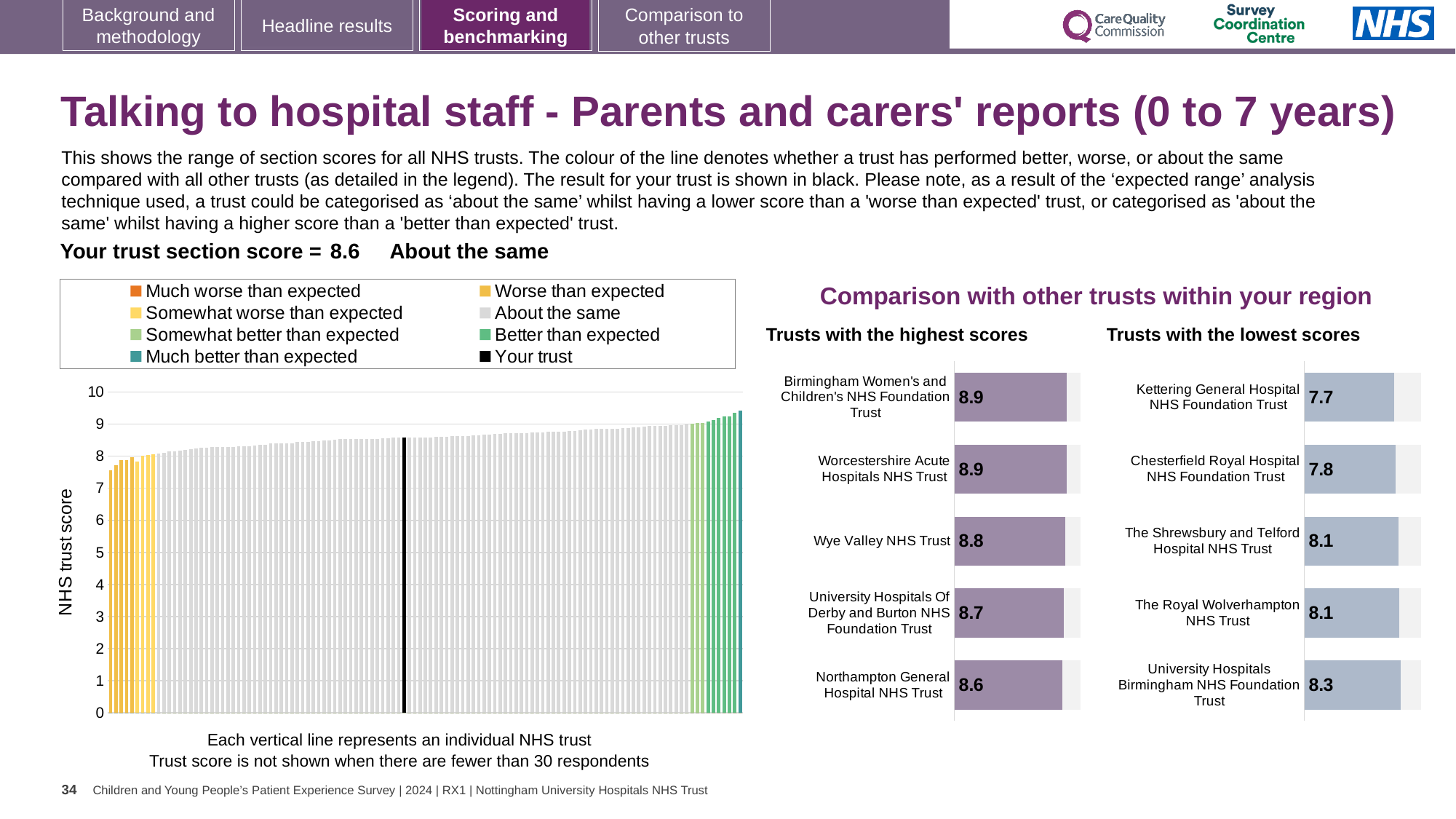
In the main NHS trust score chart, what is the section score for your trust (the black bar)? 8.6 How many entries does the legend of the main NHS trust score chart list? 8 What kind of chart is the 'Trusts with the lowest scores' chart? Bar chart In the 'Trusts with the highest scores' chart, what is the difference between the scores of Birmingham Women's and Children's NHS Foundation Trust and Northampton General Hospital NHS Trust? 0.3 In the 'Trusts with the highest scores' chart, what is the score for Wye Valley NHS Trust? 8.8 In the main NHS trust score chart, do the trust scores rise or fall from left to right? Rise In the 'Trusts with the lowest scores' chart, what is the difference between the scores of University Hospitals Birmingham NHS Foundation Trust and Kettering General Hospital NHS Foundation Trust? 0.6 How many trusts are shown in the 'Trusts with the highest scores' chart? 5 In the 'Trusts with the lowest scores' chart, what is the score for Kettering General Hospital NHS Foundation Trust? 7.7 In the main NHS trust score chart, is the lowest trust score greater or less than 7? greater In the 'Trusts with the lowest scores' chart, which trust has the lowest score? Kettering General Hospital NHS Foundation Trust In the 'Trusts with the lowest scores' chart, which has the higher score: Chesterfield Royal Hospital NHS Foundation Trust or University Hospitals Birmingham NHS Foundation Trust? University Hospitals Birmingham NHS Foundation Trust